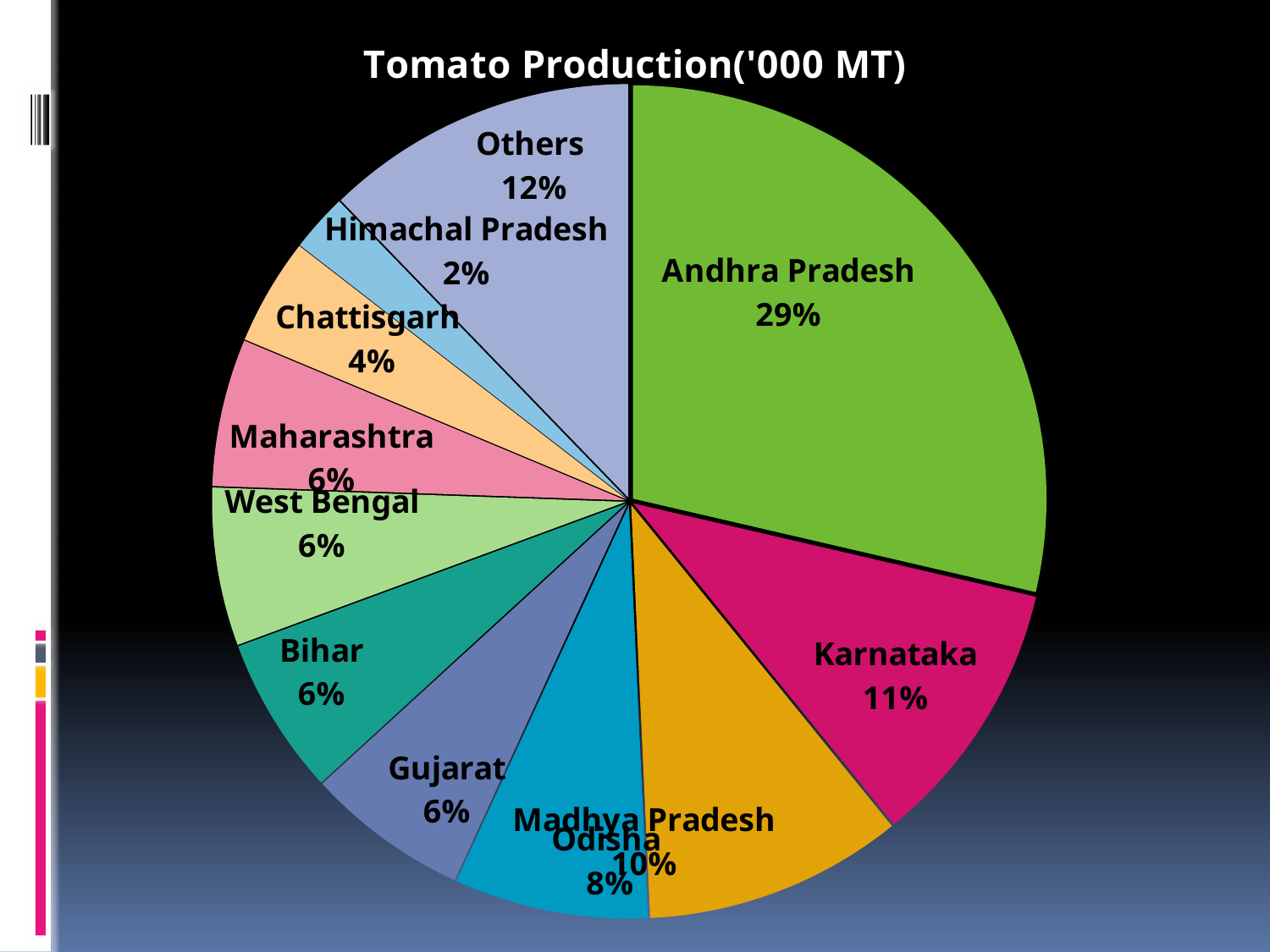
What kind of chart is shown on the slide? pie chart What percentage is shown for Others? 12% Which state has the largest share of tomato production? Andhra Pradesh What percentage is shown for Chattisgarh? 4% Which has a larger share, Karnataka or Chattisgarh? Karnataka What percentage is shown for Himachal Pradesh? 2% What share of tomato production does Andhra Pradesh account for? 29% What is the title of the chart? Tomato Production('000 MT) What is the difference in percentage points between Andhra Pradesh and Karnataka? 18 What share of tomato production does Karnataka account for? 11% Which named slice has the smallest share of tomato production? Himachal Pradesh How many slices does the pie chart have? 11